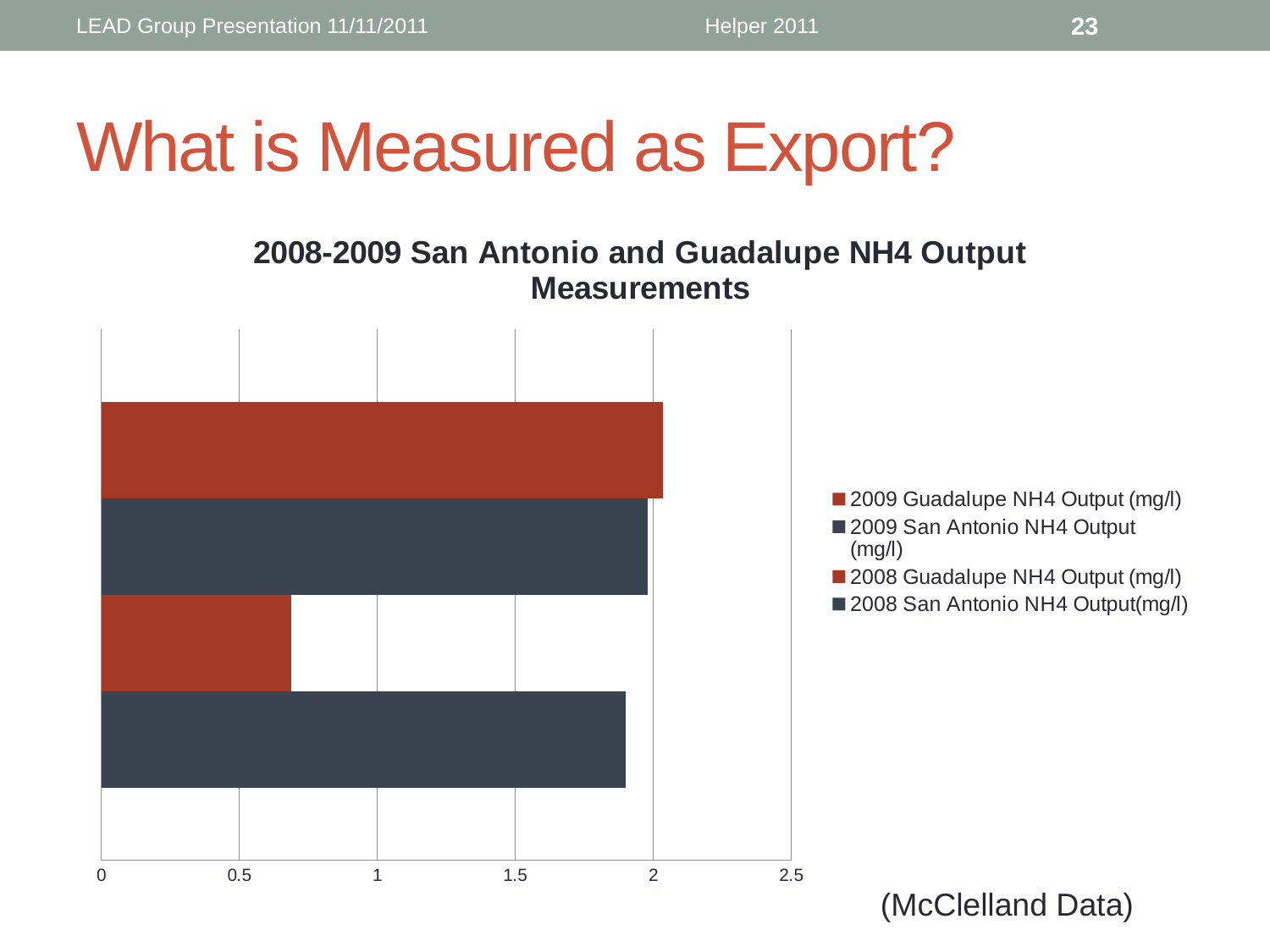
Is the value for 2008 San Antonio NH4 Output greater or less than 1.5? greater What is the title of the chart? 2008-2009 San Antonio and Guadalupe NH4 Output Measurements How many bars are plotted in the chart? 4 Which series has the lowest NH4 output value? 2008 Guadalupe NH4 Output (mg/l) What is the highest value shown on the x axis? 2.5 Is the value for 2008 Guadalupe NH4 Output greater or less than 1? less Which is larger, the 2009 Guadalupe NH4 Output or the 2008 Guadalupe NH4 Output? 2009 Guadalupe NH4 Output Which is larger, the 2008 San Antonio NH4 Output or the 2008 Guadalupe NH4 Output? 2008 San Antonio NH4 Output How many series does the legend list? 4 Is the value for 2009 San Antonio NH4 Output greater or less than 1.5? greater What kind of chart is shown on the slide? Bar chart